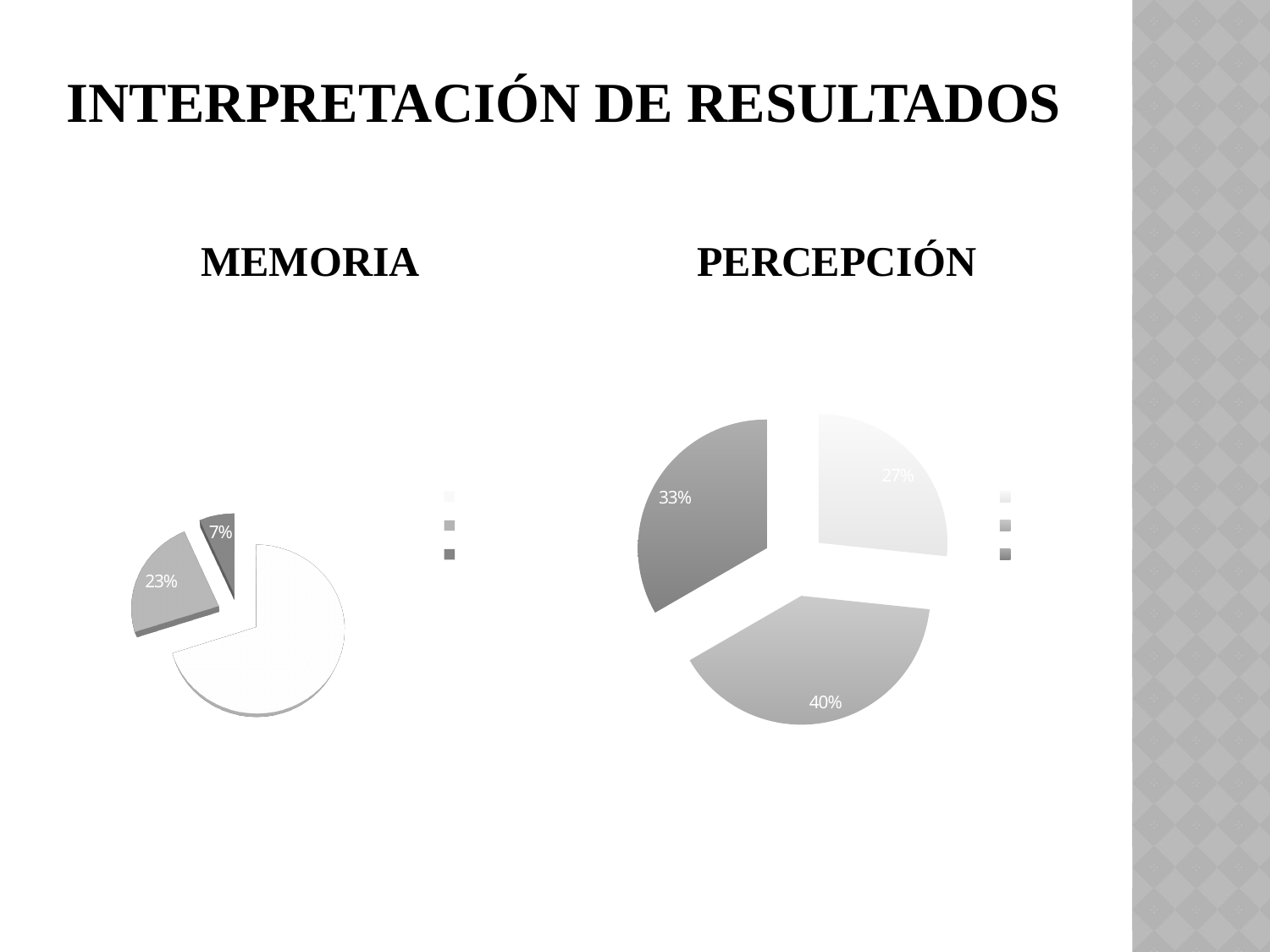
In the MEMORIA chart, is the white slice greater or less than 50% of the pie? greater In the PERCEPCIÓN chart, what is the difference in percentage points between the largest and smallest slices? 13 In the MEMORIA chart, which is larger: the dark grey slice or the medium grey slice? The medium grey slice (23%) What kind of chart is the MEMORIA chart? Pie chart How many slices does the PERCEPCIÓN pie chart have? 3 In the MEMORIA chart, what is the difference in percentage points between the 23% slice and the 7% slice? 16 In the PERCEPCIÓN chart, what is the smallest slice's value? 27% In the PERCEPCIÓN chart, what is the largest slice's value? 40% In the PERCEPCIÓN chart, what value is shown on the darkest slice? 33% In the MEMORIA chart, what value is shown on the darkest slice? 7% What kind of chart is the PERCEPCIÓN chart? Pie chart How many slices does the MEMORIA pie chart have? 3